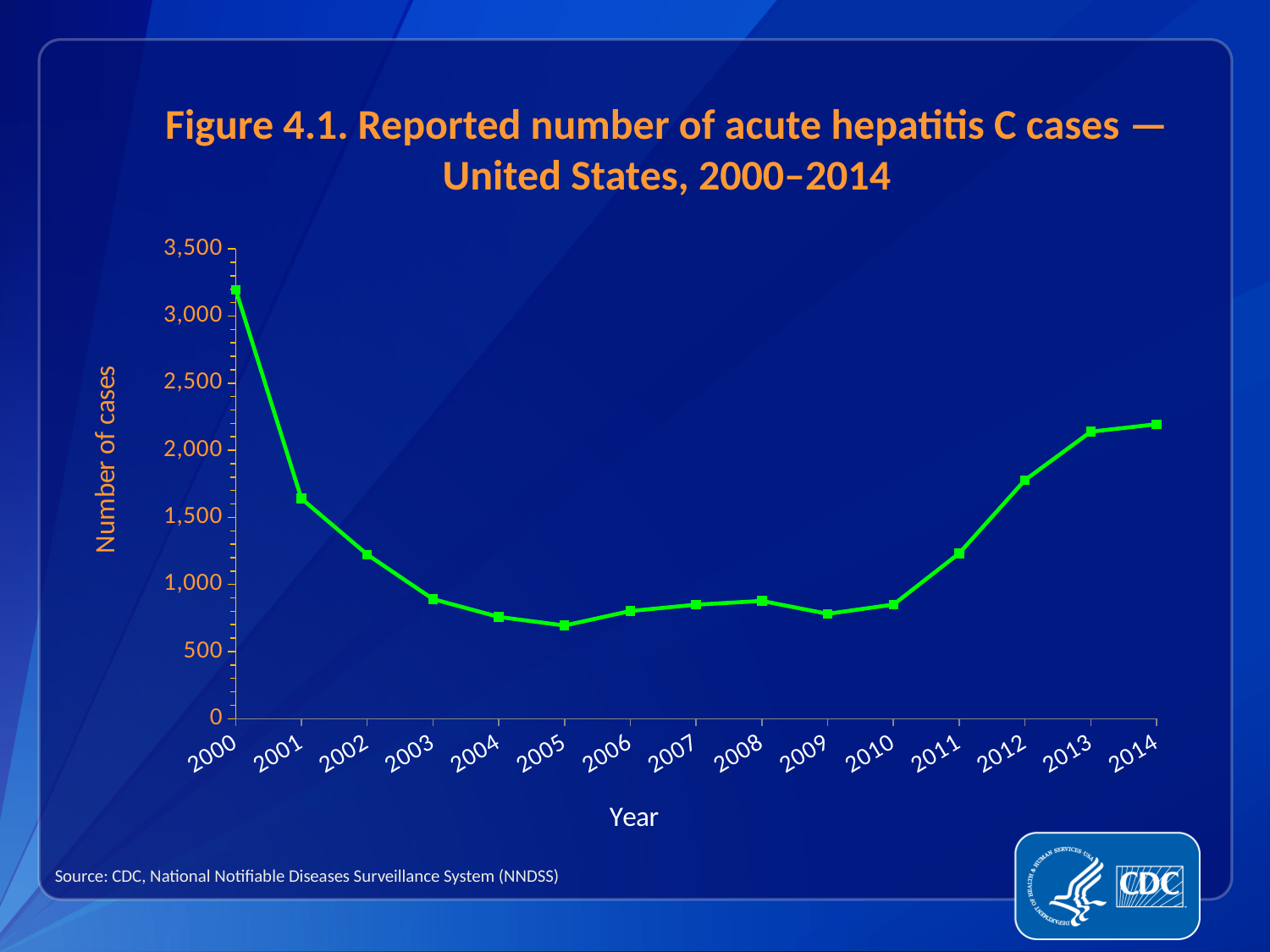
How many years are plotted on the x axis? 15 Which year has the lowest reported number of acute hepatitis C cases? 2005 Is the value for 2012 greater or less than 2,000? less What kind of chart is shown on the slide? line chart What is the label on the vertical axis? Number of cases Do the reported cases rise or fall from 2010 to 2014? rise Which year has more reported cases, 2000 or 2014? 2000 Is the value for 2013 greater or less than 2,000? greater Is the value for 2003 greater or less than 1,000? less Which year has the highest reported number of acute hepatitis C cases? 2000